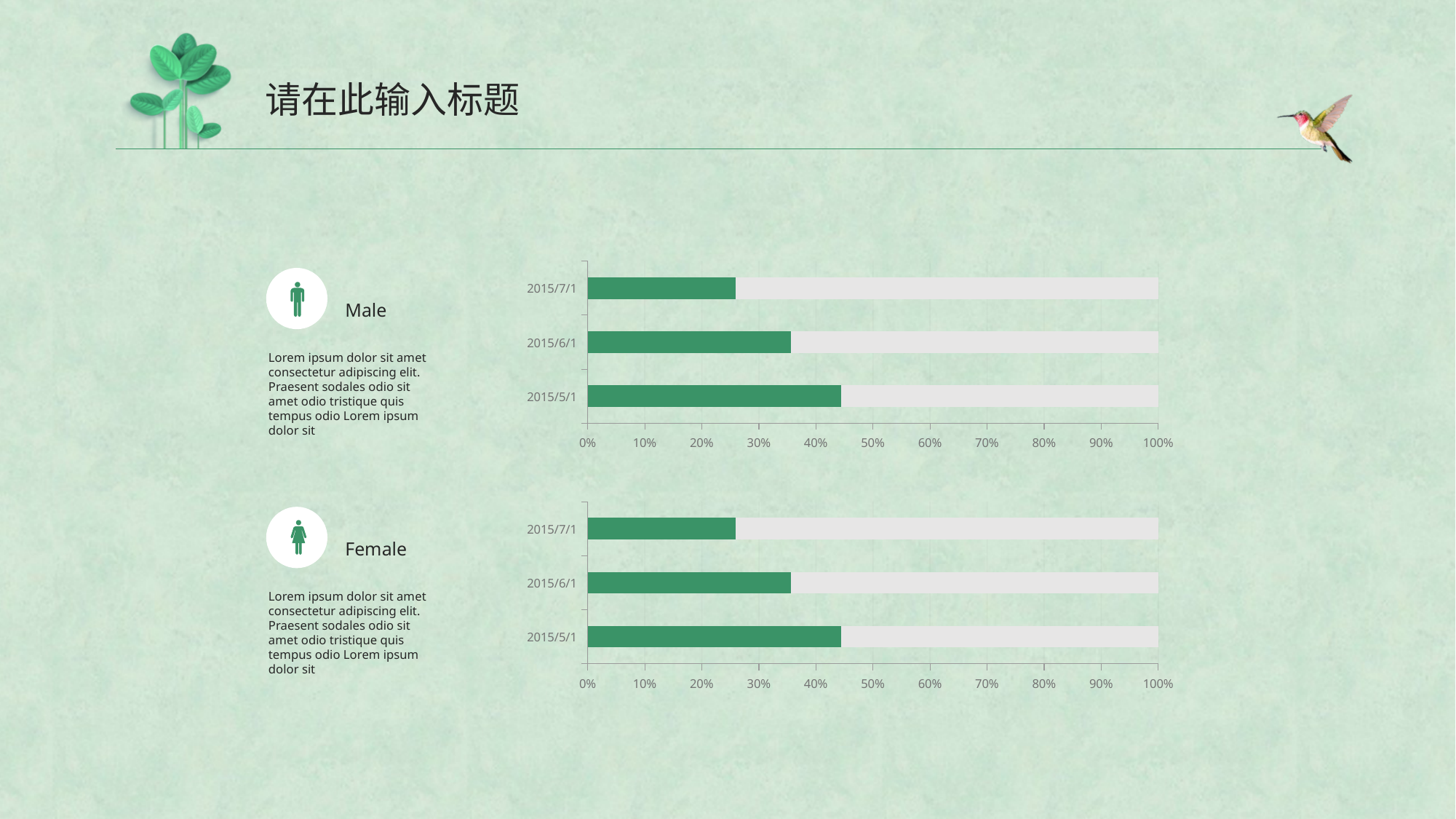
In the bottom (Female) chart, which category has the longest green bar? 2015/5/1 How many categories does the top (Male) chart show? 3 In the bottom (Female) chart, is the green bar for 2015/6/1 greater or less than 30%? greater In the bottom (Female) chart, which is larger, the green bar for 2015/6/1 or for 2015/7/1? 2015/6/1 What label appears next to the icon above the top chart? Male In the top (Male) chart, which category has the longest green bar? 2015/5/1 How many categories does the bottom (Female) chart show? 3 In the top (Male) chart, is the green bar for 2015/5/1 greater or less than 40%? greater In the top (Male) chart, is the green bar for 2015/7/1 greater or less than 30%? less What kind of chart is the top chart next to the 'Male' label? bar chart What is the highest value shown on the horizontal axis of the bottom (Female) chart? 100% In the top (Male) chart, which category has the shortest green bar? 2015/7/1